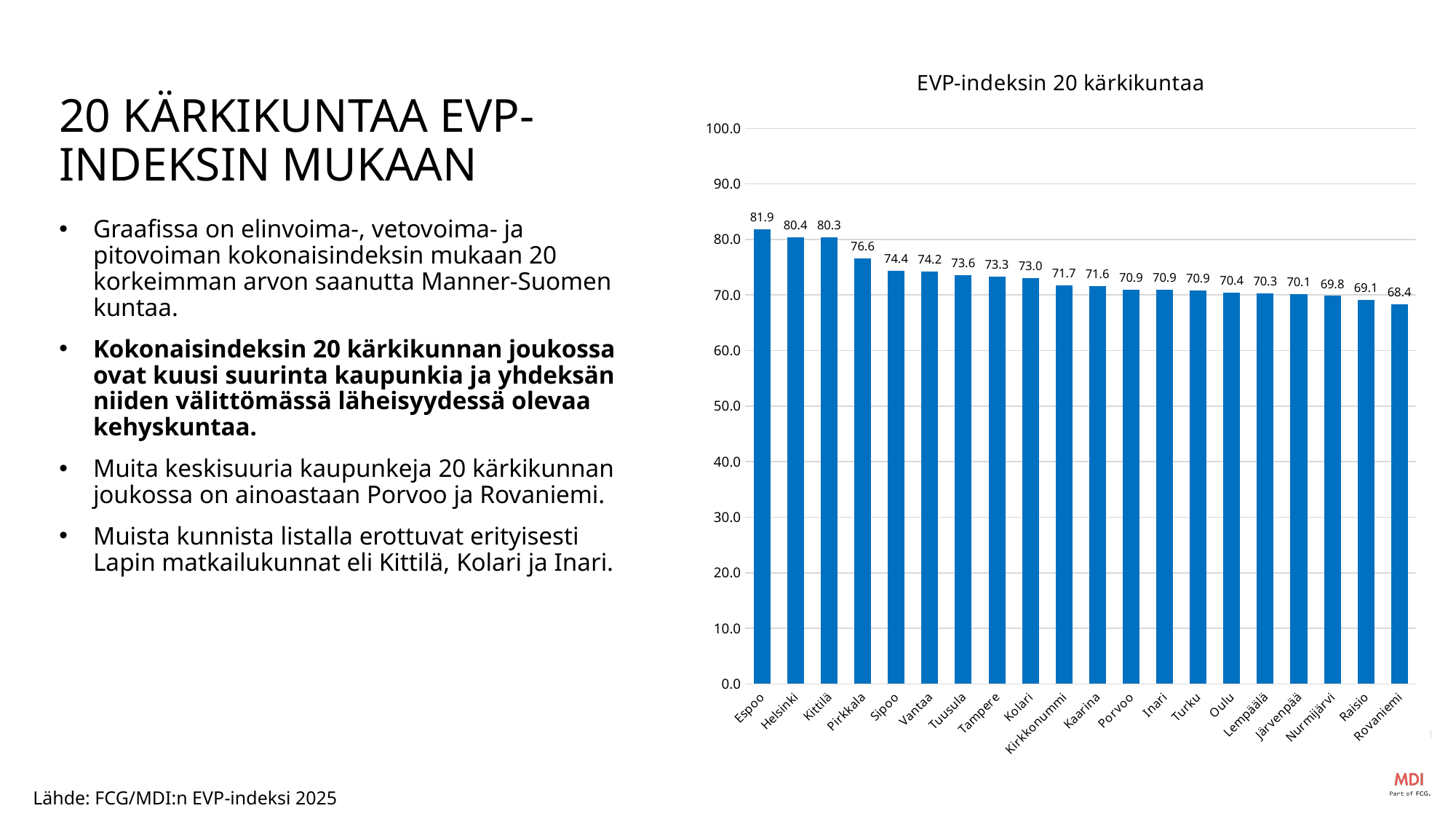
What kind of chart is shown on the slide? Bar chart Is the value for Raisio greater or less than 70.0? less Which municipality has the highest EVP index value in the chart? Espoo What is the EVP index value for Espoo? 81.9 How many municipalities are shown in the chart? 20 Which municipality has the lowest EVP index value in the chart? Rovaniemi What is the title of the chart? EVP-indeksin 20 kärkikuntaa What is the EVP index value for Kittilä? 80.3 What is the difference between the EVP index values of Helsinki and Pirkkala? 3.8 What is the EVP index value for Rovaniemi? 68.4 What is the difference between the EVP index values of Espoo and Rovaniemi? 13.5 Which has a higher EVP index value, Sipoo or Kolari? Sipoo